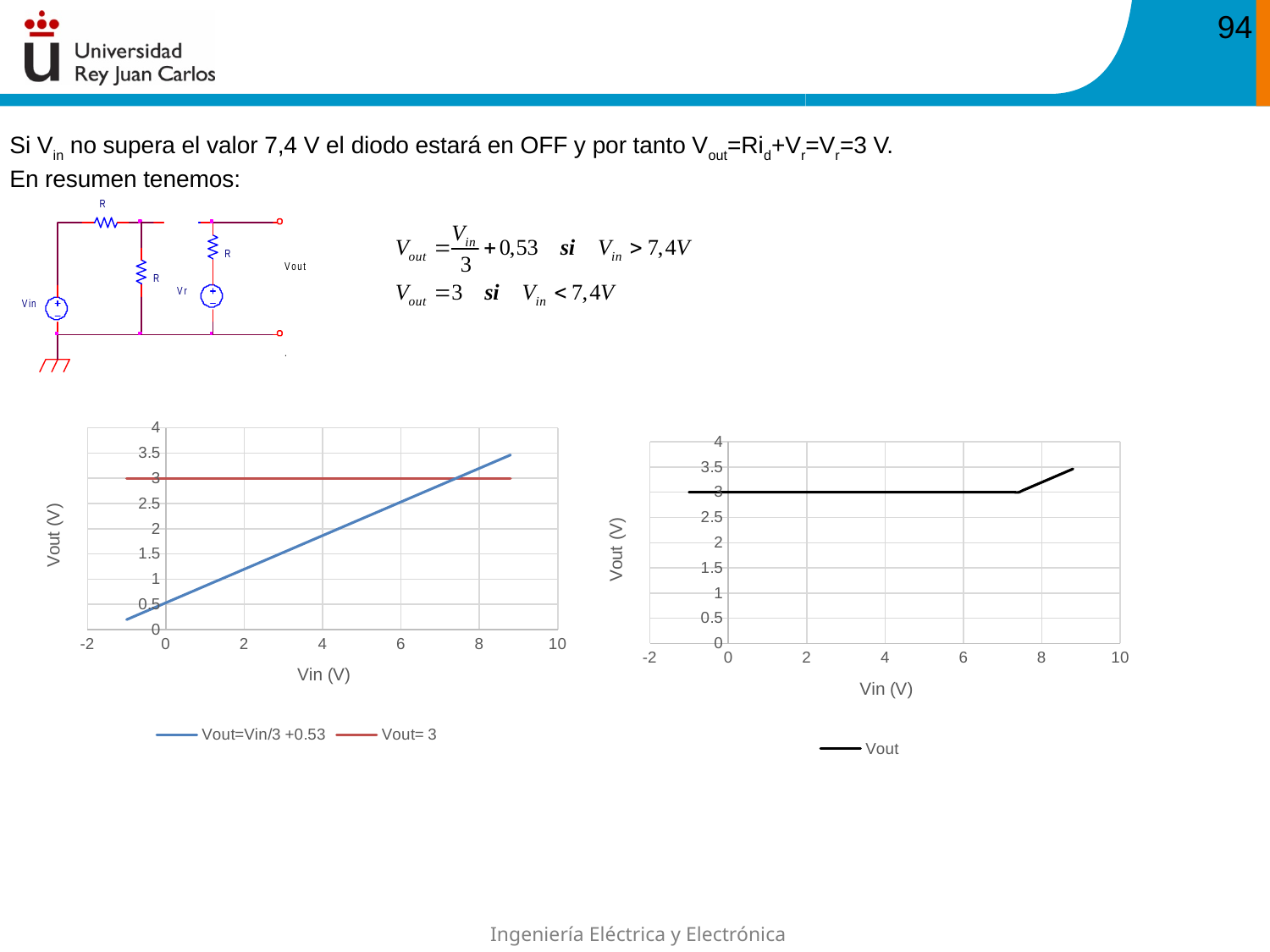
In the left chart, does the series Vout=Vin/3 +0.53 rise or fall as Vin increases? rise In the right chart, does Vout rise, fall or stay flat between Vin = 0 and Vin = 6? stay flat What is the x-axis title of the right chart? Vin (V) In the left chart, at Vin = 2, which series has the higher Vout value: Vout=Vin/3 +0.53 or Vout= 3? Vout= 3 In the right chart, is the value of Vout at Vin = 4 greater or less than 2? greater In the left chart, is the value of Vout=Vin/3 +0.53 at Vin = 2 greater or less than 2? less How many series does the legend of the right chart list? 1 In the left chart, is the value of Vout=Vin/3 +0.53 at Vin = 6 greater or less than 3? less How many series does the legend of the left chart list? 2 In the left chart, what are the two legend entries? Vout=Vin/3 +0.53 and Vout= 3 In the left chart, at what constant Vout value does the red series Vout= 3 stay? 3 What type of chart is the left chart? line chart